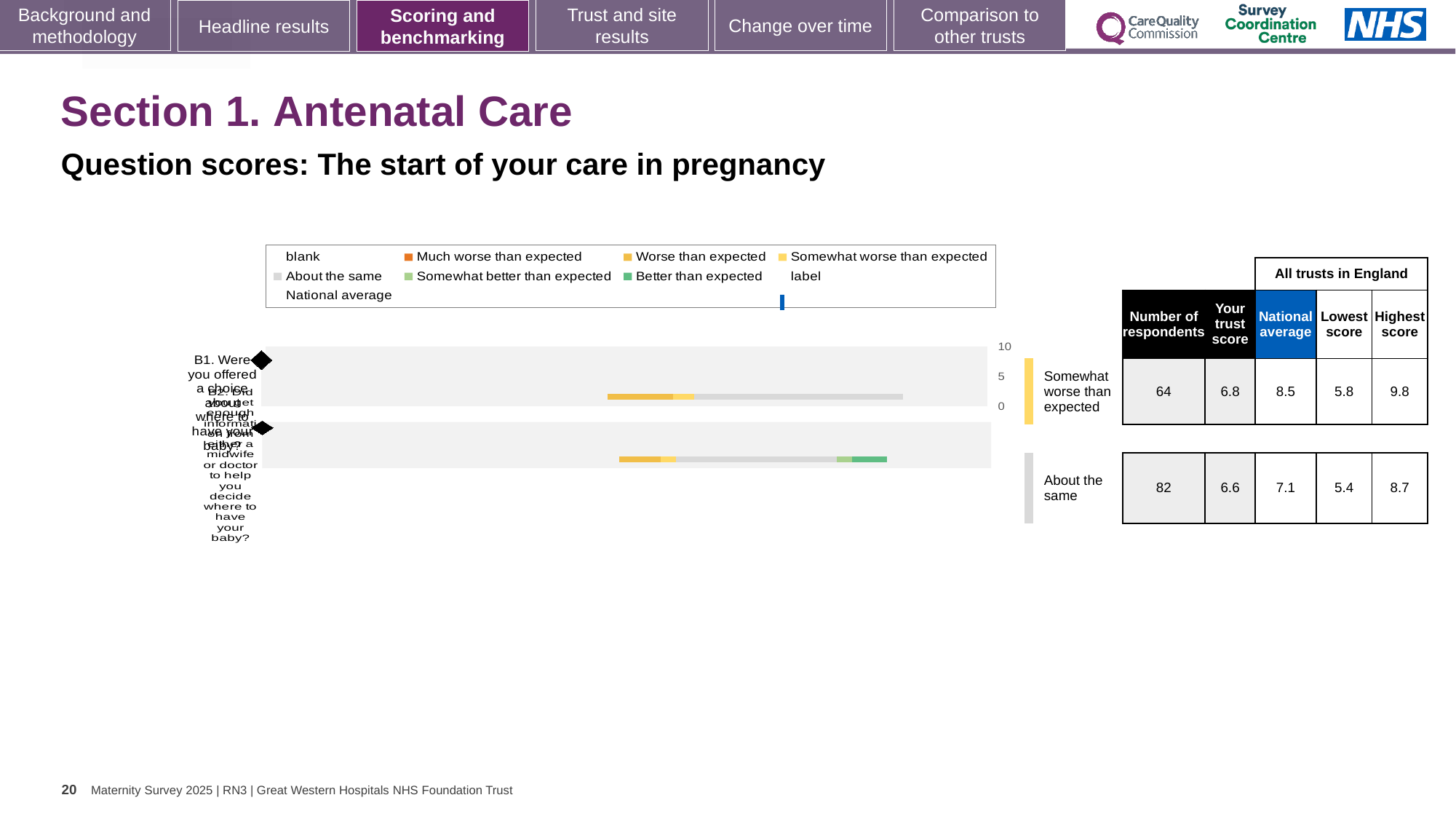
What is the difference between the national average and the trust score for question B1? 1.7 What is the trust score for question B2? 6.6 Which benchmark category is question B1 placed in? Somewhat worse than expected How many questions (categories) are plotted in the chart? 2 What kind of chart is shown on the slide? bar chart What is the highest score across all trusts in England for question B2? 8.7 How many respondents answered question B2? 82 Which question had more respondents, B1 or B2? B2 What is the lowest score across all trusts in England for question B1? 5.8 What is the trust score for question B1 (Were you offered a choice about where to have your baby?)? 6.8 What is the national average for question B1? 8.5 Which benchmark category is question B2 placed in? About the same